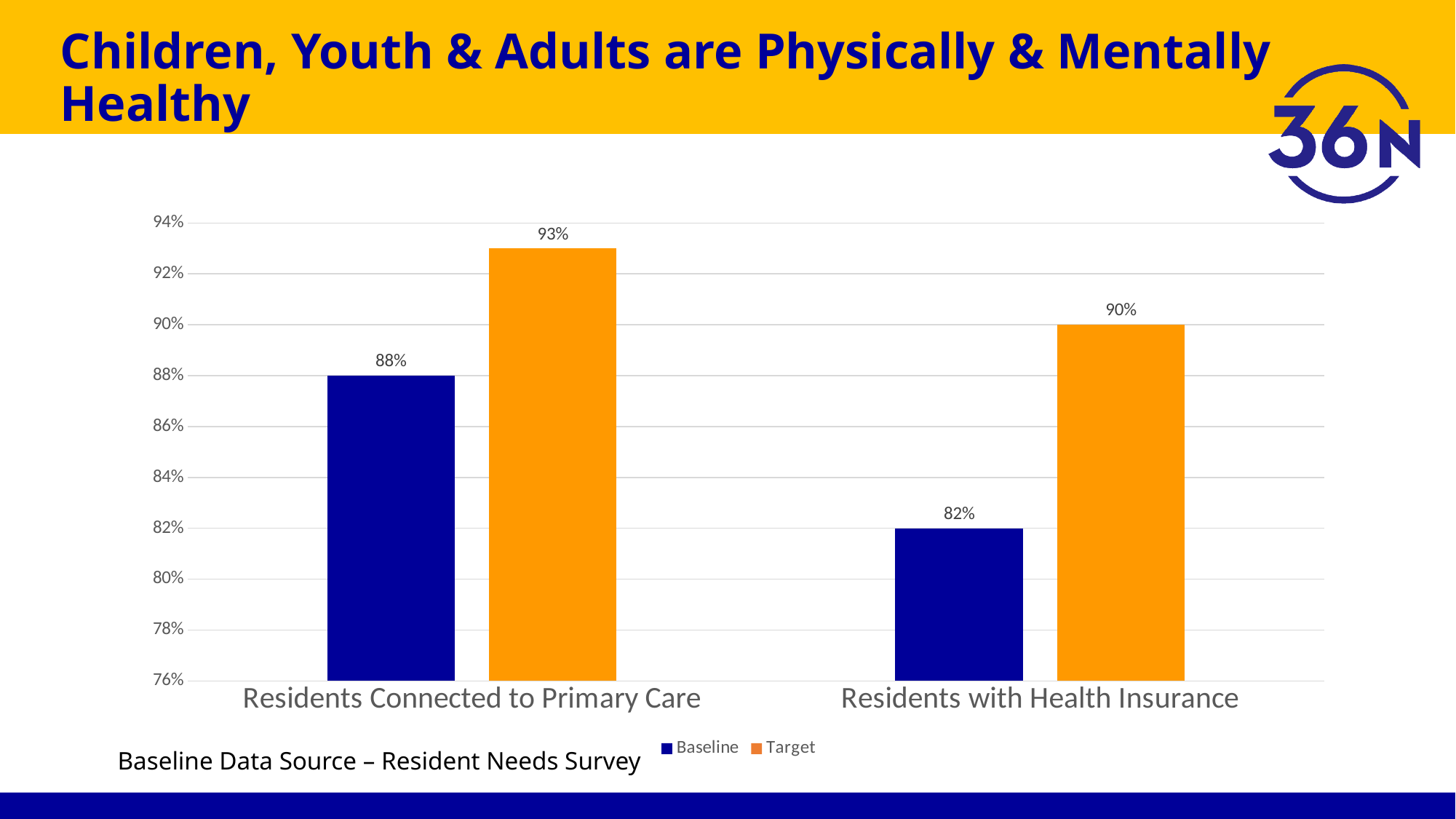
Which category has the lowest Baseline value? Residents with Health Insurance What is the Baseline value for Residents with Health Insurance? 82% How many categories are shown on the x axis? 2 What is the Baseline value for Residents Connected to Primary Care? 88% What is the difference between the Target and Baseline values for Residents Connected to Primary Care? 5% How many series does the legend list? 2 What kind of chart is shown on the slide? Bar chart Which category has the highest Target value? Residents Connected to Primary Care Which is larger: the Baseline value for Residents Connected to Primary Care or the Target value for Residents with Health Insurance? Target value for Residents with Health Insurance What is the Target value for Residents with Health Insurance? 90% What is the difference between the Target and Baseline values for Residents with Health Insurance? 8% What is the Target value for Residents Connected to Primary Care? 93%